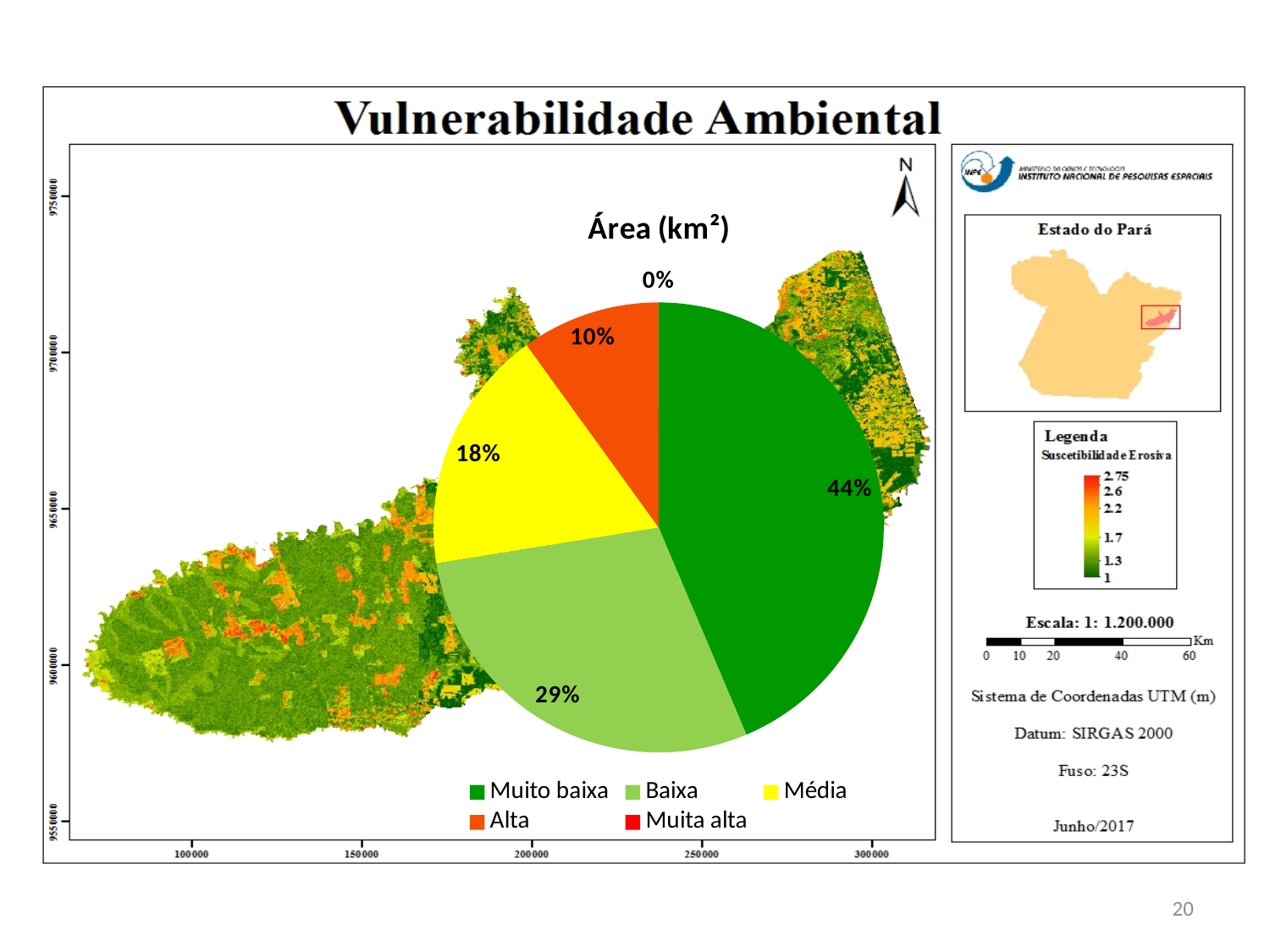
Which share is larger, Média or Alta? Média What share of the pie does Muito baixa represent? 44% What share of the pie does Muita alta represent? 0% What type of chart is shown on the slide? pie chart What share of the pie does Alta represent? 10% How many categories does the pie chart legend list? 5 What is the title of the pie chart? Área (km²) What is the difference in percentage points between the Muito baixa and Baixa shares? 15% Which category has the smallest share of the pie? Muita alta Which category has the largest share of the pie? Muito baixa